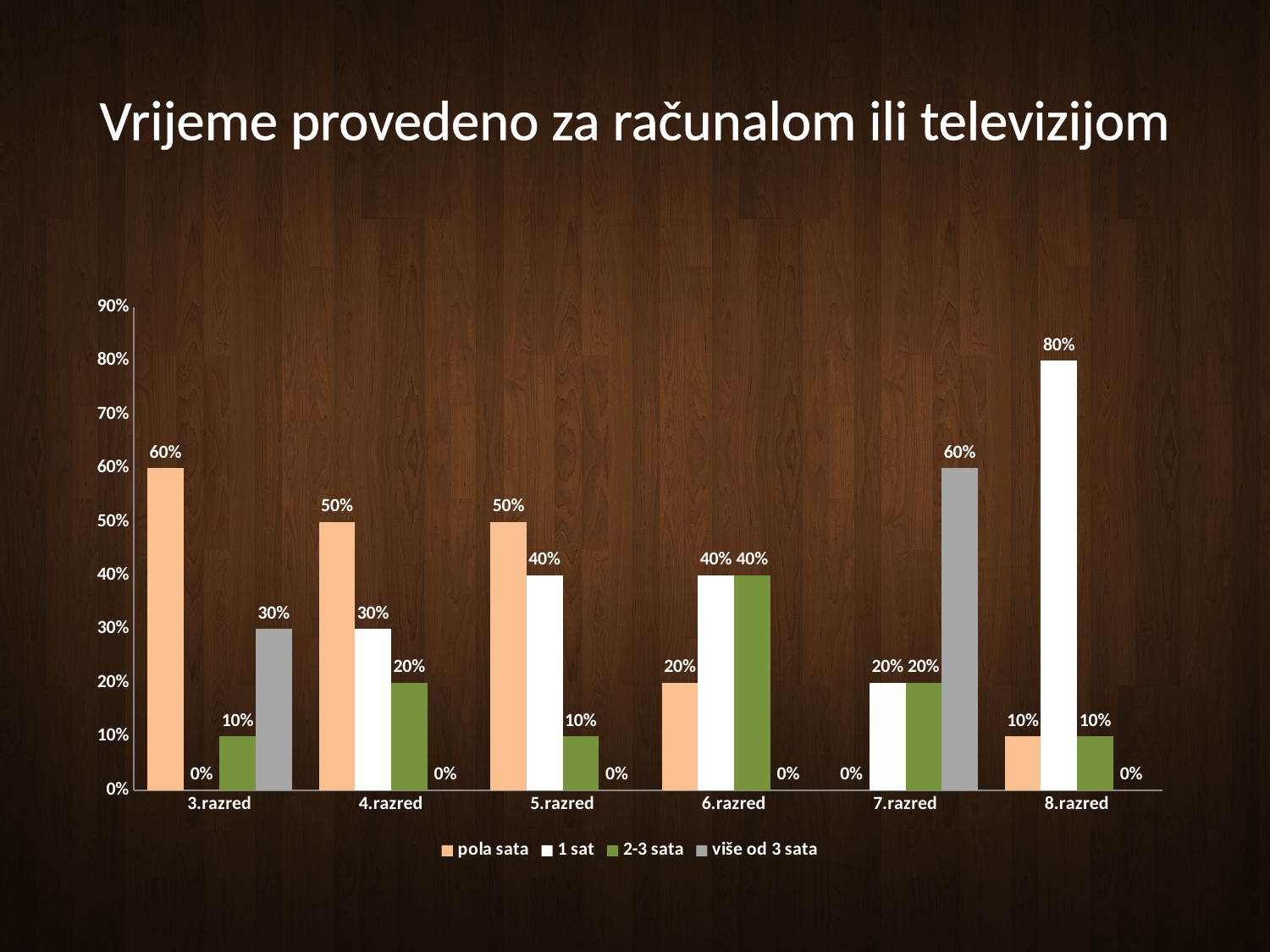
What is the difference between the "pola sata" value in 3.razred and the "pola sata" value in 4.razred? 10% What kind of chart is shown on the slide? Bar chart What is the title of the chart? Vrijeme provedeno za računalom ili televizijom Which category has the highest value for "1 sat"? 8.razred What is the value for "pola sata" in 3.razred? 60% How many categories are shown on the x axis? 6 Which is larger: the "1 sat" value in 5.razred or the "1 sat" value in 4.razred? 5.razred What is the value for "više od 3 sata" in 7.razred? 60% How many series does the legend list? 4 What is the value for "2-3 sata" in 6.razred? 40% Which category has the lowest value for "pola sata"? 7.razred What is the value for "1 sat" in 8.razred? 80%